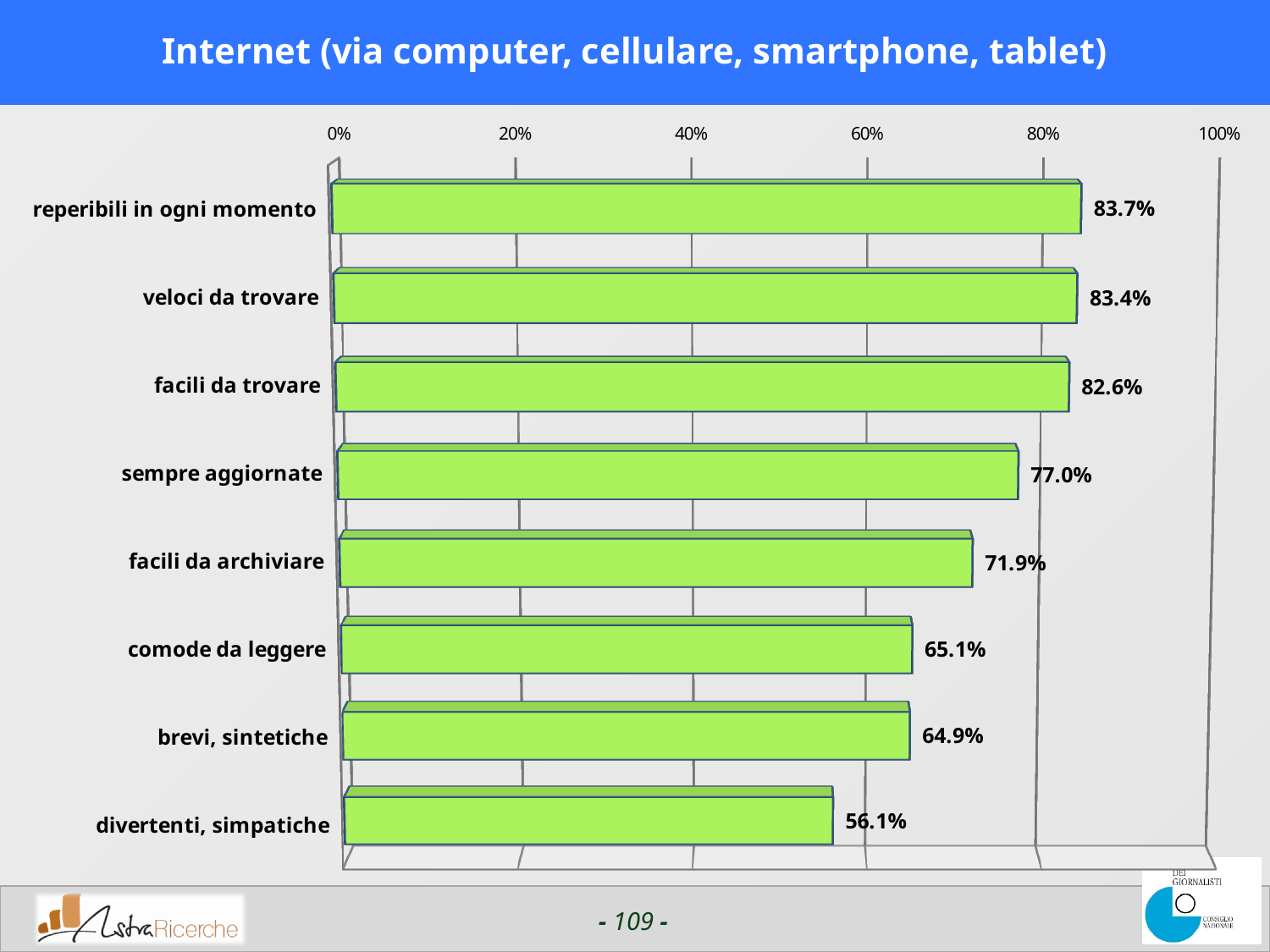
Is the value for "brevi, sintetiche" greater or less than 60%? greater What is the difference between the values for "sempre aggiornate" and "facili da archiviare"? 5.1% What kind of chart is shown on the slide? bar chart What is the title of the slide? Internet (via computer, cellulare, smartphone, tablet) What is the value for "divertenti, simpatiche"? 56.1% What is the value for "facili da archiviare"? 71.9% What is the value for "sempre aggiornate"? 77.0% Which is larger, the value for "facili da trovare" or the value for "comode da leggere"? facili da trovare Which category has the lowest value? divertenti, simpatiche Which category has the highest value? reperibili in ogni momento What is the difference between the values for "reperibili in ogni momento" and "divertenti, simpatiche"? 27.6% How many categories are shown in the chart? 8